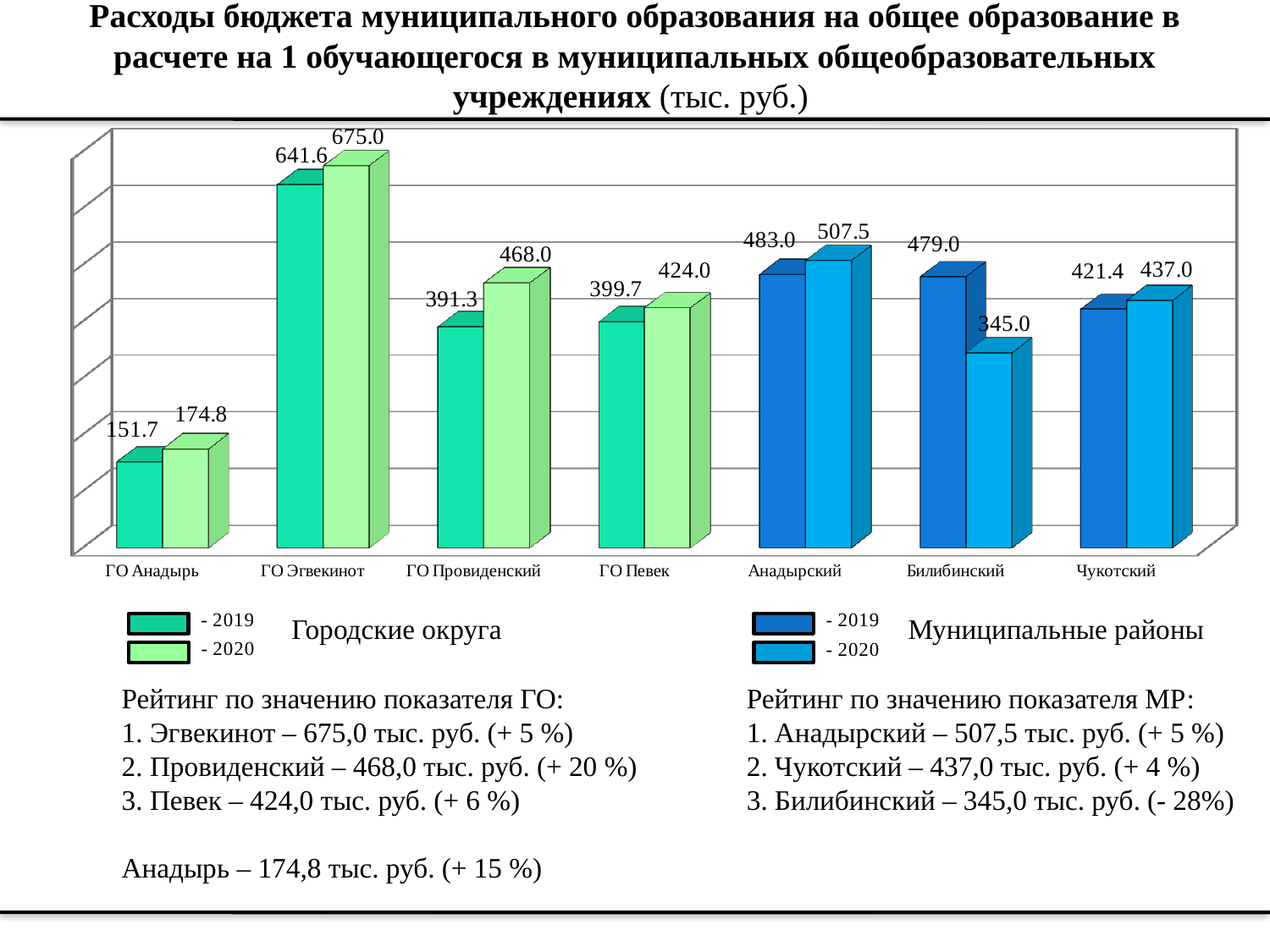
How many categories are shown on the x axis of the chart? 7 Which category has the highest 2020 value? ГО Эгвекинот What is the 2020 value for ГО Эгвекинот? 675.0 What is the 2019 value for Билибинский? 479.0 Which is larger for Билибинский: the 2019 value or the 2020 value? 2019 What is the difference between the 2020 and 2019 values for ГО Провиденский? 76.7 What is the difference between the 2019 and 2020 values for Билибинский? 134.0 Which is larger: the 2020 value for Анадырский or the 2020 value for Чукотский? Анадырский What kind of chart is shown on the slide? bar chart Which category has the lowest 2019 value? ГО Анадырь What is the 2020 value for ГО Анадырь? 174.8 Which two years are listed in the legend for Городские округа? 2019 and 2020